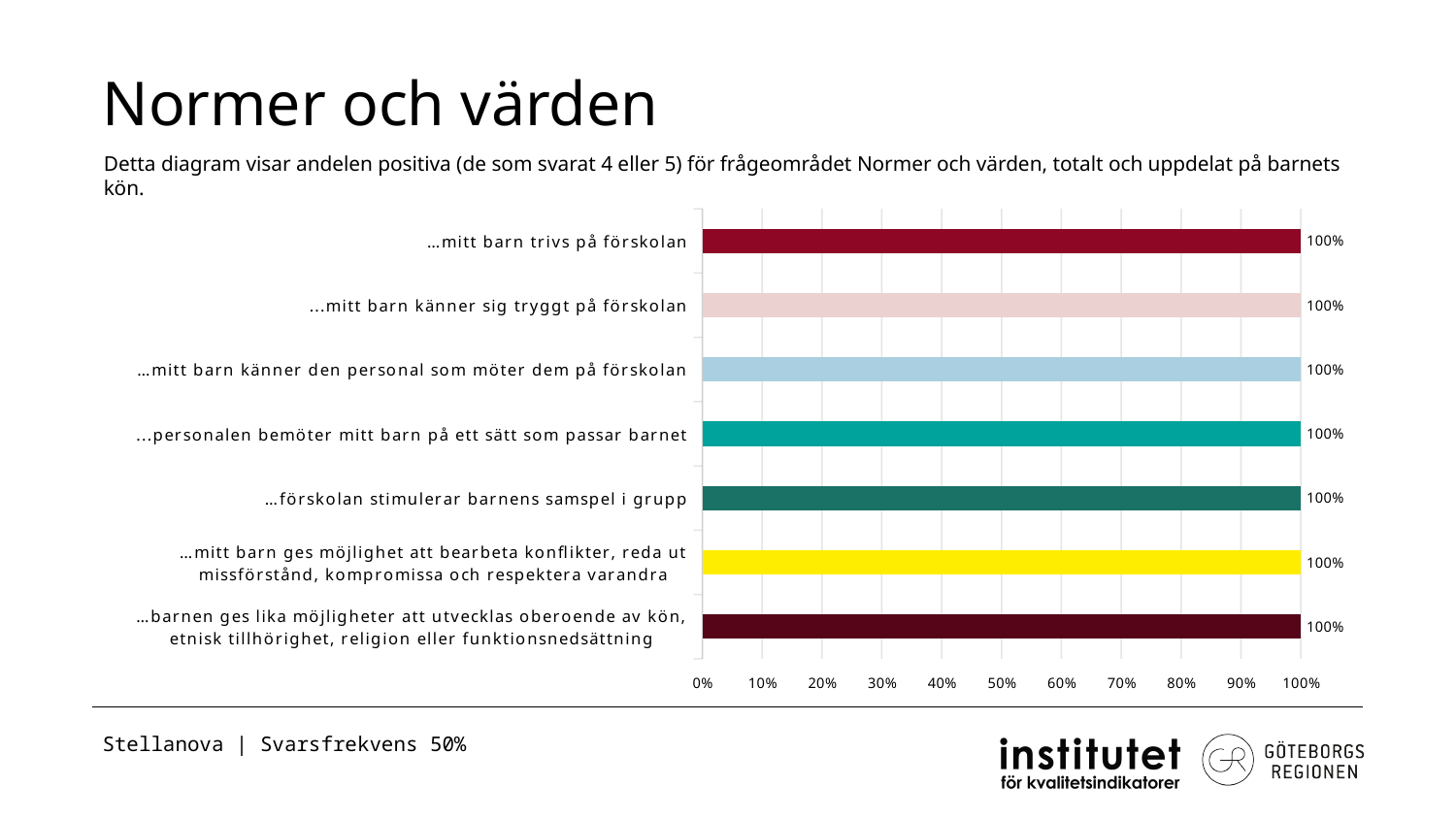
What value is shown for "...personalen bemöter mitt barn på ett sätt som passar barnet"? 100% What is the title of the slide containing the chart? Normer och värden How many categories (bars) does the chart show? 7 Is the value for "…mitt barn känner den personal som möter dem på förskolan" greater or less than 90%? greater Do all the bars in the chart show the same value? Yes, all show 100% What value is shown for "...mitt barn känner sig tryggt på förskolan"? 100% What value is shown for "…mitt barn trivs på förskolan"? 100% What value is shown for "…barnen ges lika möjligheter att utvecklas oberoende av kön, etnisk tillhörighet, religion eller funktionsnedsättning"? 100% What value is shown for "…förskolan stimulerar barnens samspel i grupp"? 100% What kind of chart is shown on the slide? Bar chart What is the highest tick value shown on the horizontal axis? 100% What is the difference between the value for "…mitt barn trivs på förskolan" and the value for "…förskolan stimulerar barnens samspel i grupp"? 0%